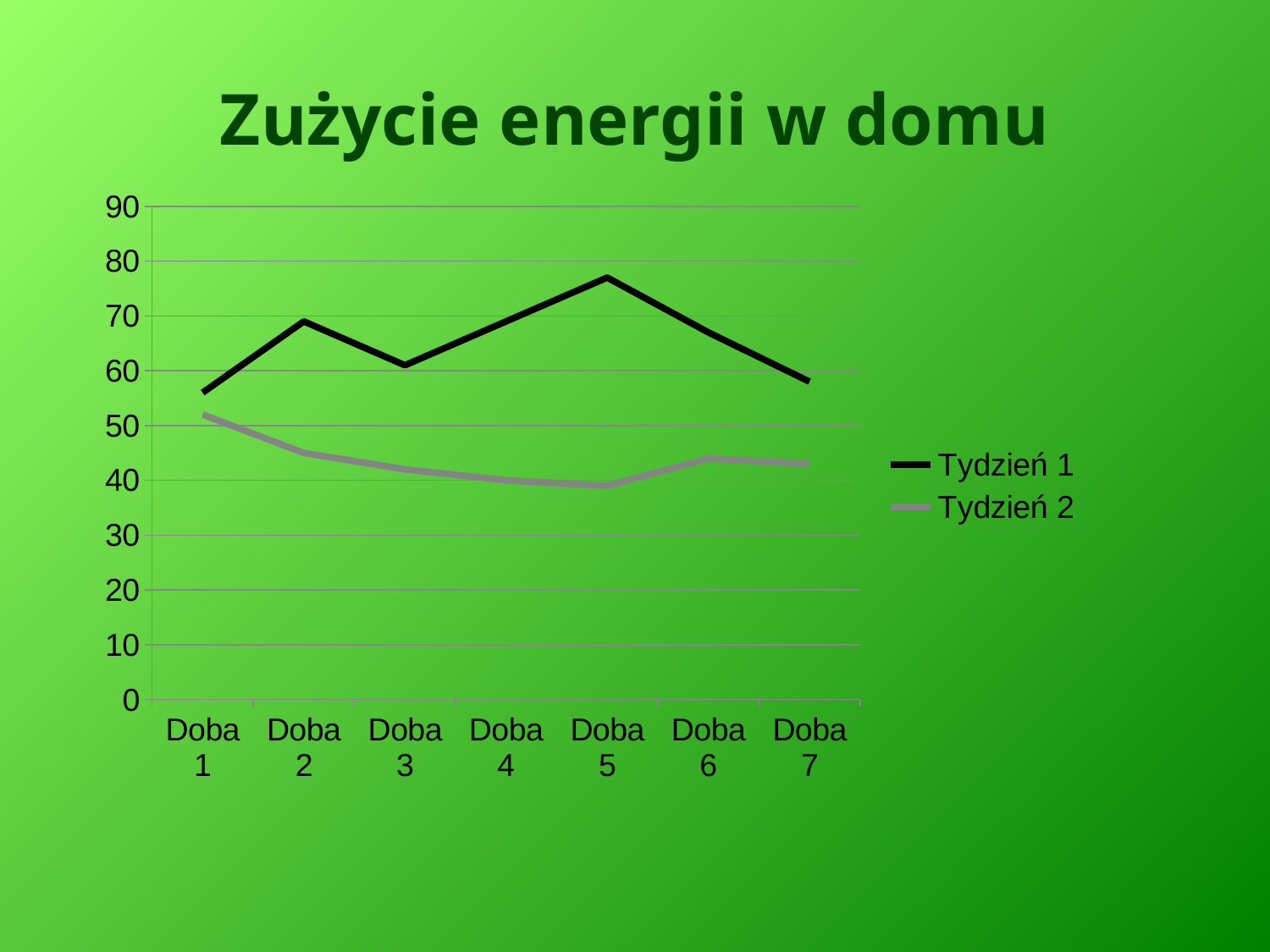
Is the value for Tydzień 1 at Doba 5 greater or less than 70? greater Which series is drawn with the black line? Tydzień 1 What is the title of the chart? Zużycie energii w domu How many series does the legend list? 2 Is the value for Tydzień 2 at Doba 4 greater or less than 50? less On which day (Doba) does Tydzień 2 reach its lowest value? Doba 5 Which series has the larger value at Doba 3, Tydzień 1 or Tydzień 2? Tydzień 1 On which day (Doba) does Tydzień 1 reach its highest value? Doba 5 What kind of chart is shown on the slide? line chart Is the value for Tydzień 1 at Doba 1 greater or less than 50? greater Does the Tydzień 2 line rise or fall from Doba 1 to Doba 5? fall How many categories are shown on the x axis? 7